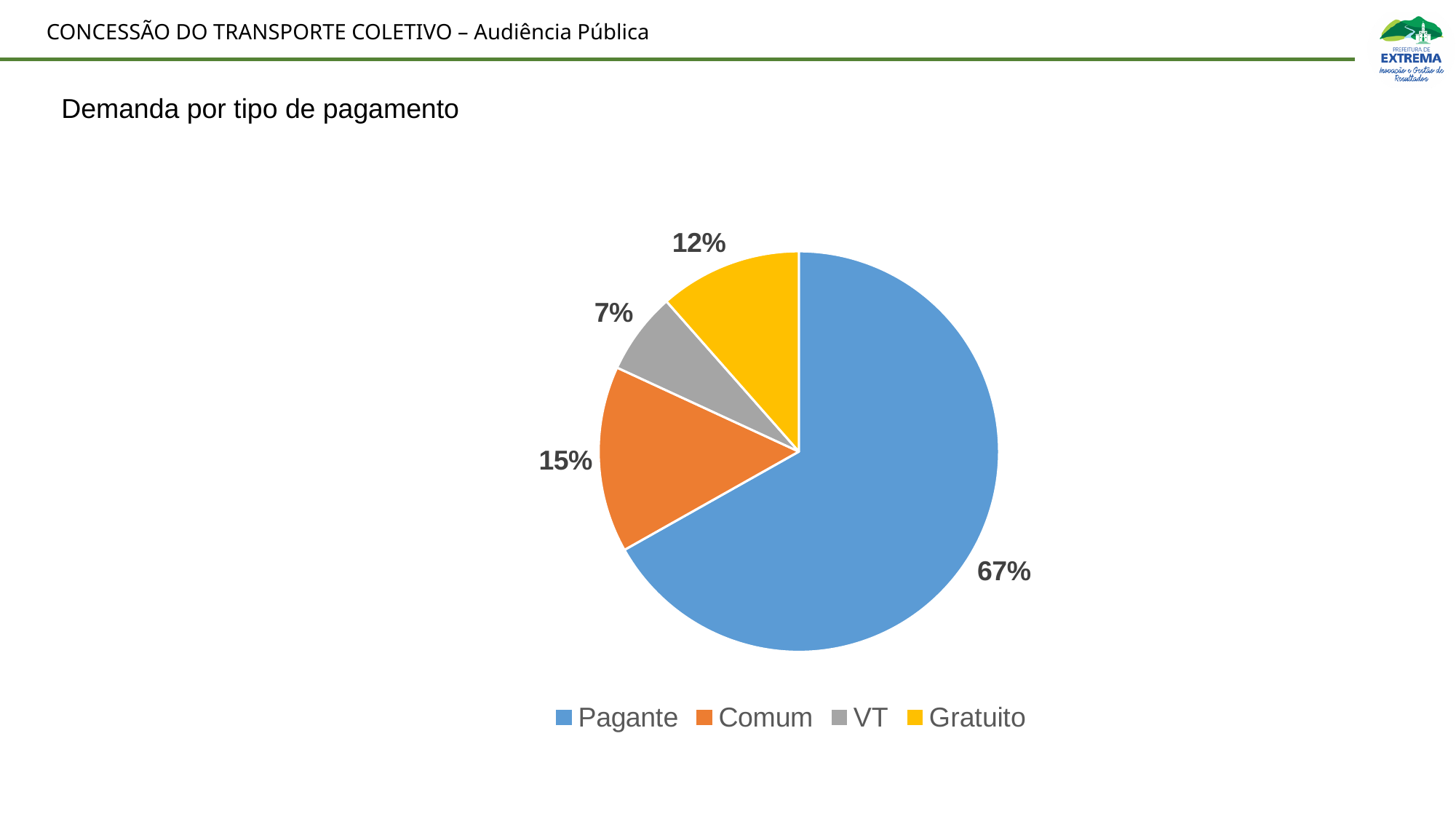
Which is larger, the share for Gratuito or the share for VT? Gratuito What colour is the Gratuito slice? yellow What share of the pie does Comum represent? 15% How many categories are shown in the pie chart? 4 Which category has the largest slice of the pie? Pagante Which category has the smallest slice of the pie? VT What share of the pie does Gratuito represent? 12% What share of the pie does VT represent? 7% What is the difference in percentage points between Pagante and Comum? 52 What type of chart is shown on the slide? pie chart What is the title of the chart? Demanda por tipo de pagamento